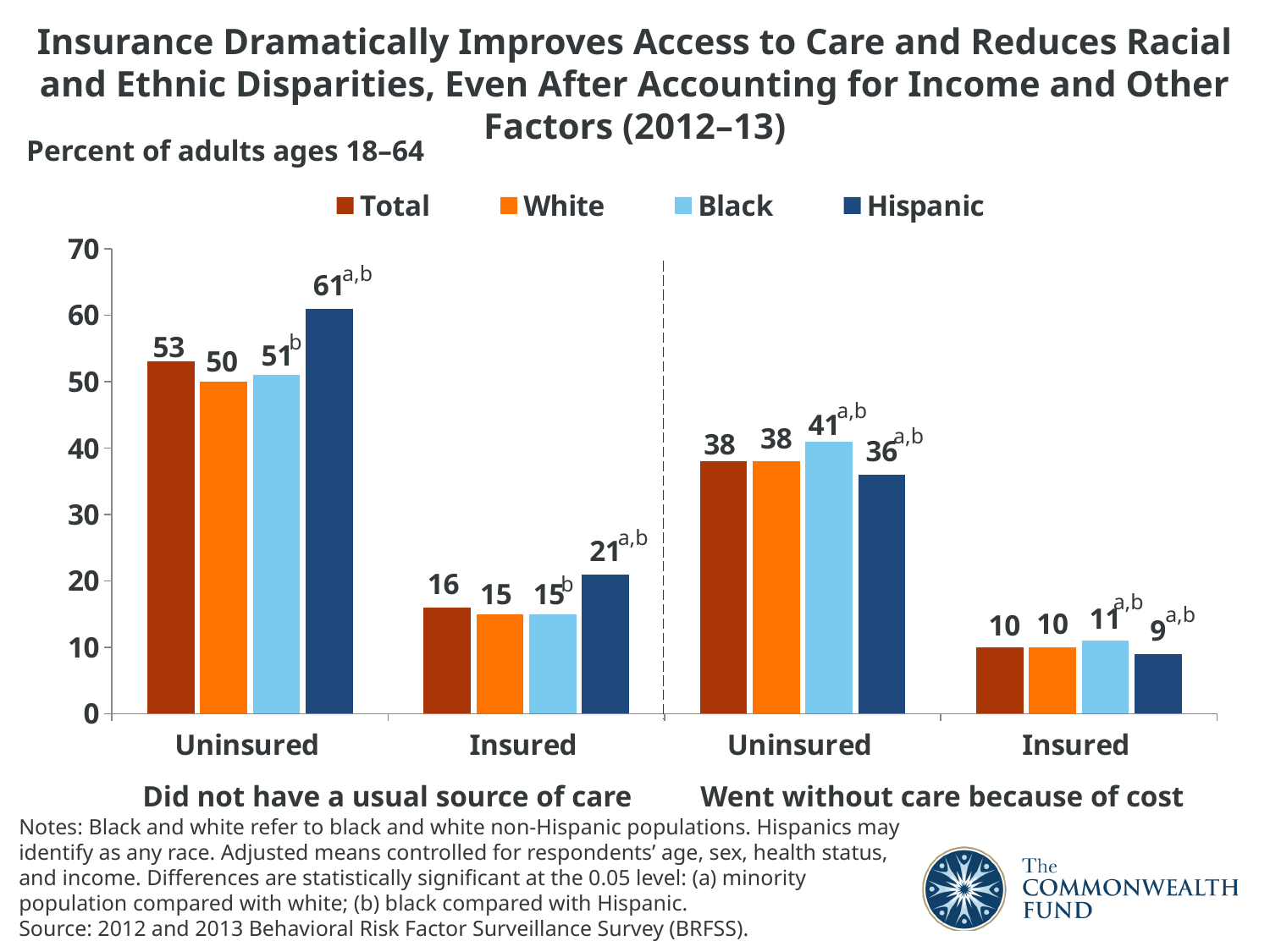
For insured adults who did not have a usual source of care, which is larger: the Hispanic value or the Total value? Hispanic What kind of chart is shown on the slide? bar chart Among uninsured adults who did not have a usual source of care, which group has the highest value? Hispanic Among insured adults who went without care because of cost, which group has the lowest value? Hispanic What is the value for Total adults who were insured and went without care because of cost? 10 What colour represents the Hispanic series in the legend? dark blue What is the value for Hispanic adults who were uninsured and did not have a usual source of care? 61 How many series does the legend list? 4 What is the difference between the Black and Hispanic values for uninsured adults who went without care because of cost? 5 What is the value for Black adults who were uninsured and went without care because of cost? 41 Is the value for Total uninsured adults who went without care because of cost greater or less than 40? less What is the difference between the Hispanic and White values for uninsured adults who did not have a usual source of care? 11